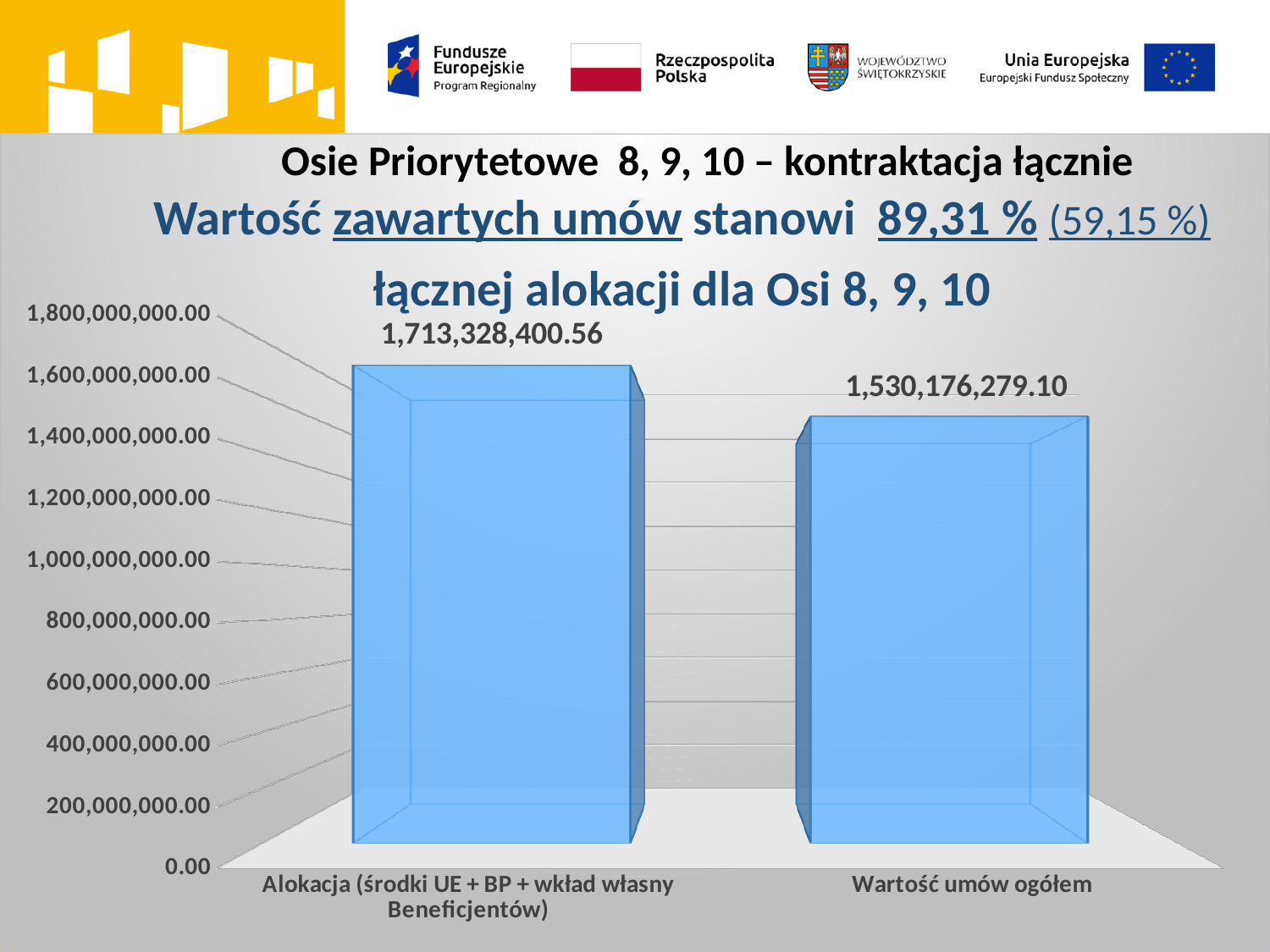
What is the difference between the value for Alokacja (środki UE + BP + wkład własny Beneficjentów) and the value for Wartość umów ogółem? 183,152,121.46 What is the value for Wartość umów ogółem? 1,530,176,279.10 Which category has the highest value? Alokacja (środki UE + BP + wkład własny Beneficjentów) Do the values rise or fall from the first category to the second along the x axis? fall What colour are the bars on the chart? blue Which is larger: the value for Alokacja (środki UE + BP + wkład własny Beneficjentów) or the value for Wartość umów ogółem? Alokacja (środki UE + BP + wkład własny Beneficjentów) How many categories are shown on the chart? 2 Is the value for Wartość umów ogółem greater or less than 1,600,000,000.00? less What is the value for Alokacja (środki UE + BP + wkład własny Beneficjentów)? 1,713,328,400.56 Is the value for Alokacja (środki UE + BP + wkład własny Beneficjentów) greater or less than 1,600,000,000.00? greater What kind of chart is shown on the slide? bar chart Which category has the lowest value? Wartość umów ogółem